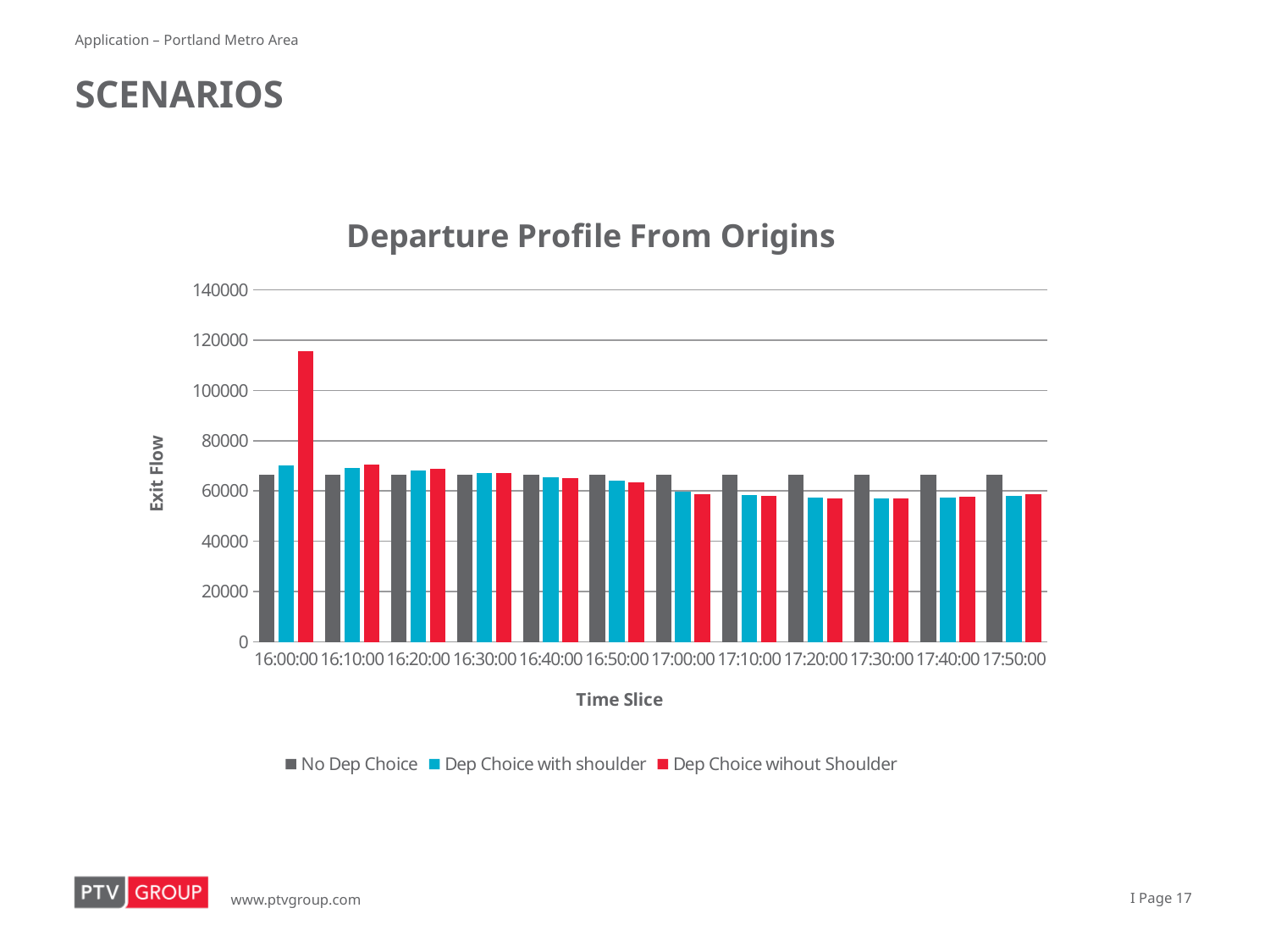
How many series does the legend of the Departure Profile From Origins chart list? 3 Do the Dep Choice with shoulder values rise or fall from 16:00:00 to 17:00:00? fall Is the Dep Choice with shoulder value at 17:30:00 greater or less than 60000? less Is the Dep Choice wihout Shoulder value at 16:00:00 greater or less than 100000? greater Which series is shown in red in the chart? Dep Choice wihout Shoulder What type of chart is shown on the slide? bar chart How many time slices are shown on the x axis of the chart? 12 At which time slice is the Dep Choice wihout Shoulder value highest? 16:00:00 At 17:00:00, which is larger: No Dep Choice or Dep Choice with shoulder? No Dep Choice What is the title of the vertical axis of the chart? Exit Flow At 16:00:00, which is larger: No Dep Choice or Dep Choice wihout Shoulder? Dep Choice wihout Shoulder Is the No Dep Choice value at 16:00:00 greater or less than 60000? greater